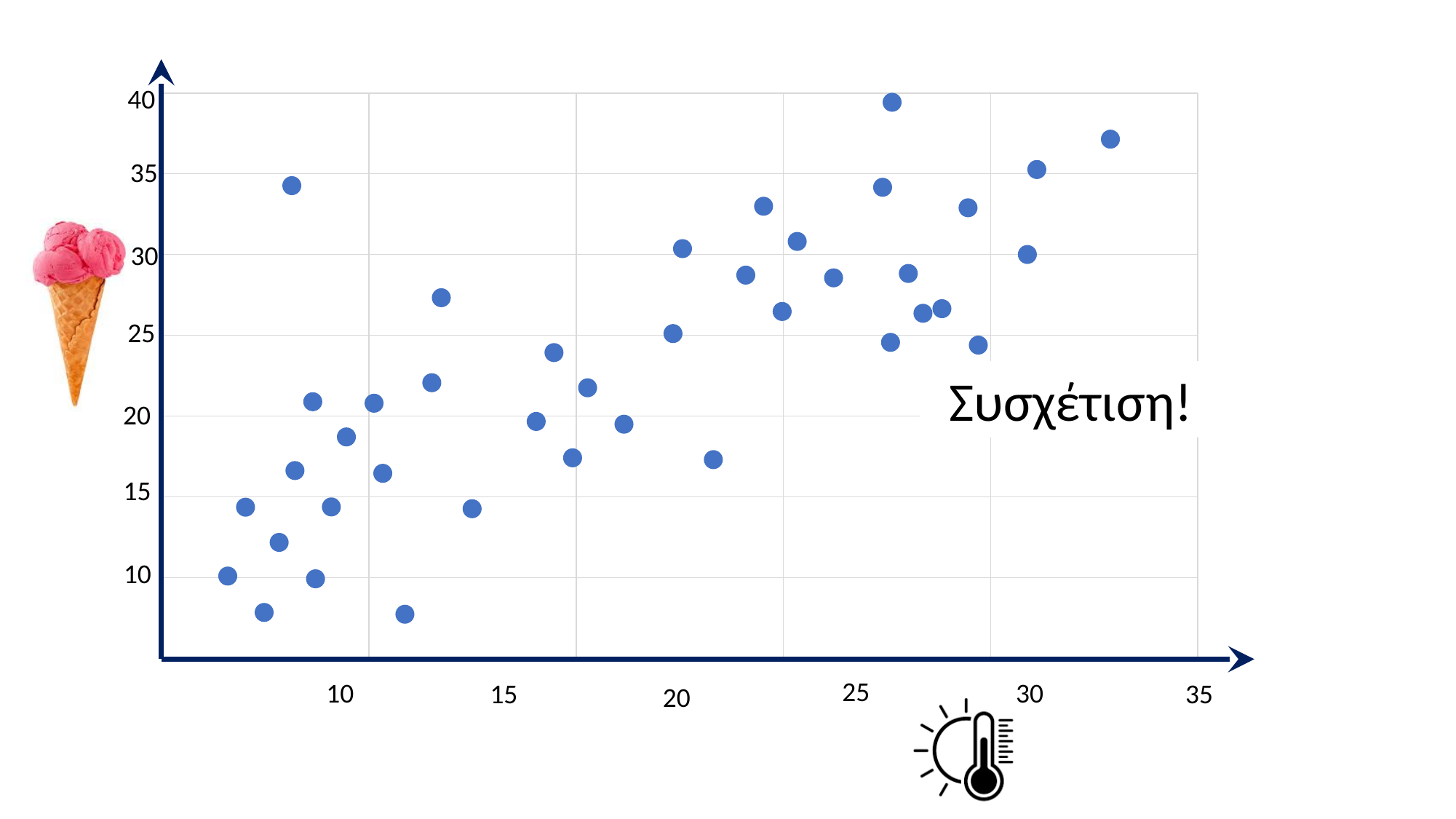
Do the plotted values generally rise or fall as the x value increases? rise What is the highest tick value shown on the y axis? 40 Is the y value of the highest point on the chart greater or less than 35? greater Is the y value of the lowest point on the chart greater or less than 10? less What kind of chart is shown on the slide? scatter plot What text annotation is written inside the chart area? Συσχέτιση!